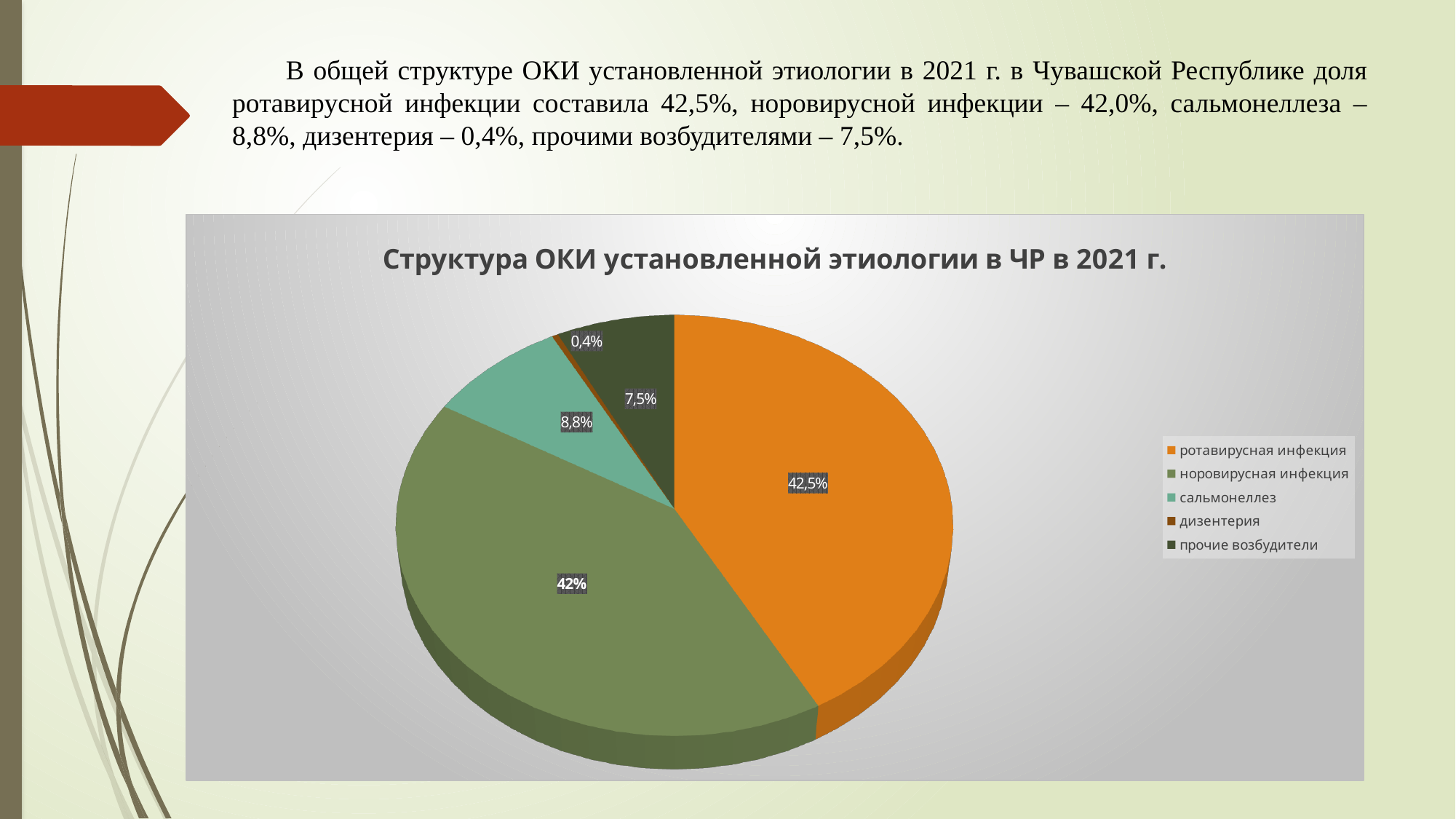
What share of the pie is норовирусная инфекция? 42% What share of the pie is сальмонеллез? 8,8% Which category has the smallest share of the pie? дизентерия What type of chart is shown on the slide? pie chart What is the difference between the shares of сальмонеллез and прочие возбудители? 1,3% What share of the pie is ротавирусная инфекция? 42,5% What is the title of the chart? Структура ОКИ установленной этиологии в ЧР в 2021 г. Which category has the largest share of the pie? ротавирусная инфекция What share of the pie is прочие возбудители? 7,5% Which is larger: the share of сальмонеллез or the share of прочие возбудители? сальмонеллез How many categories does the pie chart show? 5 What share of the pie is дизентерия? 0,4%